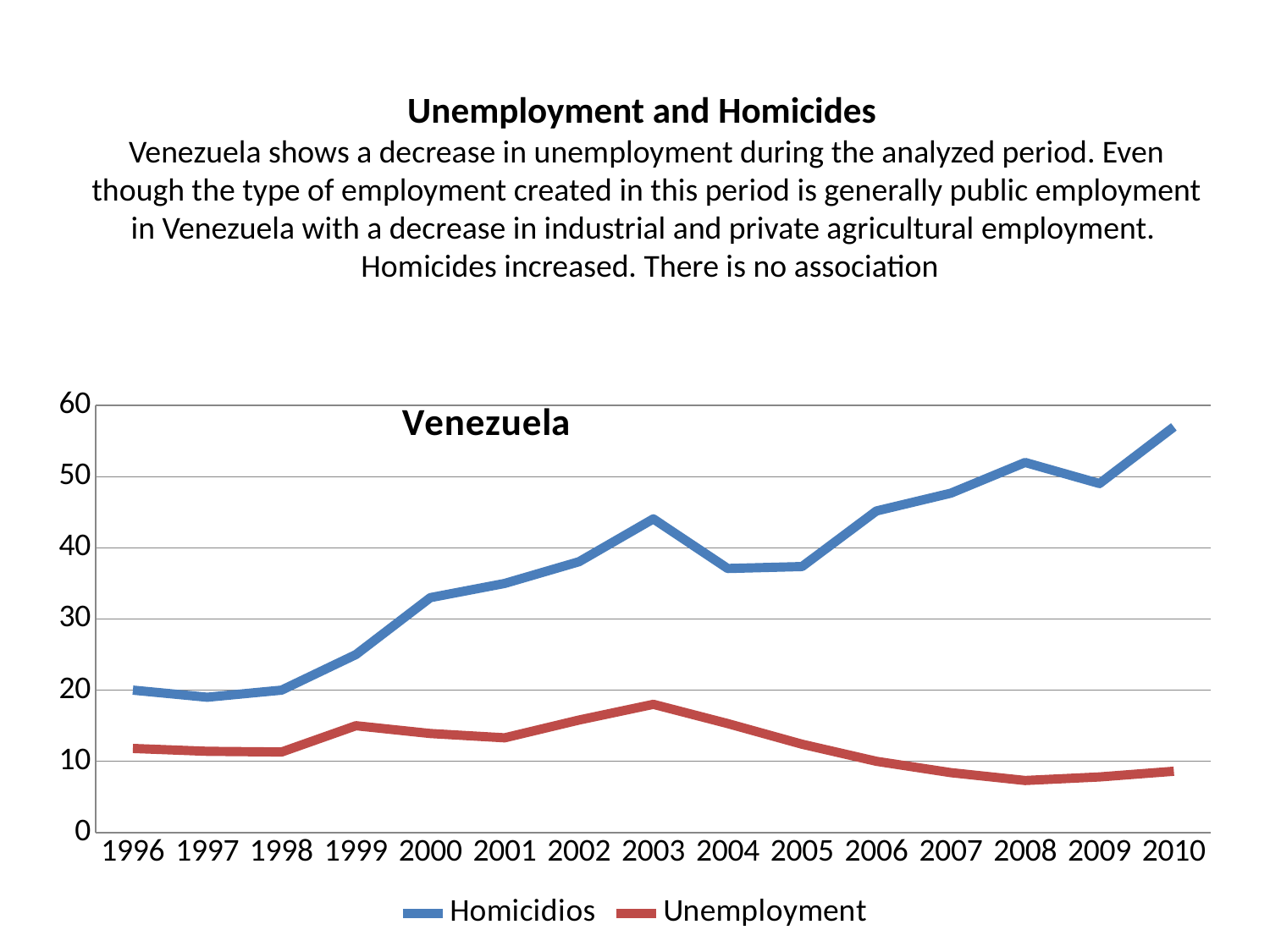
In which year does the Homicidios series reach its highest value? 2010 How many years are plotted along the x axis of the chart? 15 What kind of chart is shown on the slide? line chart Is the Unemployment value for 2003 greater or less than 20? less Is the Unemployment value for 2008 greater or less than 10? less What title is printed inside the chart area? Venezuela Is the Homicidios value for 2010 greater or less than 50? greater Which is larger, the Homicidios value for 2003 or for 2004? 2003 In which year does the Unemployment series reach its highest value? 2003 Does the Unemployment series rise or fall between 2003 and 2008? fall How many series does the chart legend list? 2